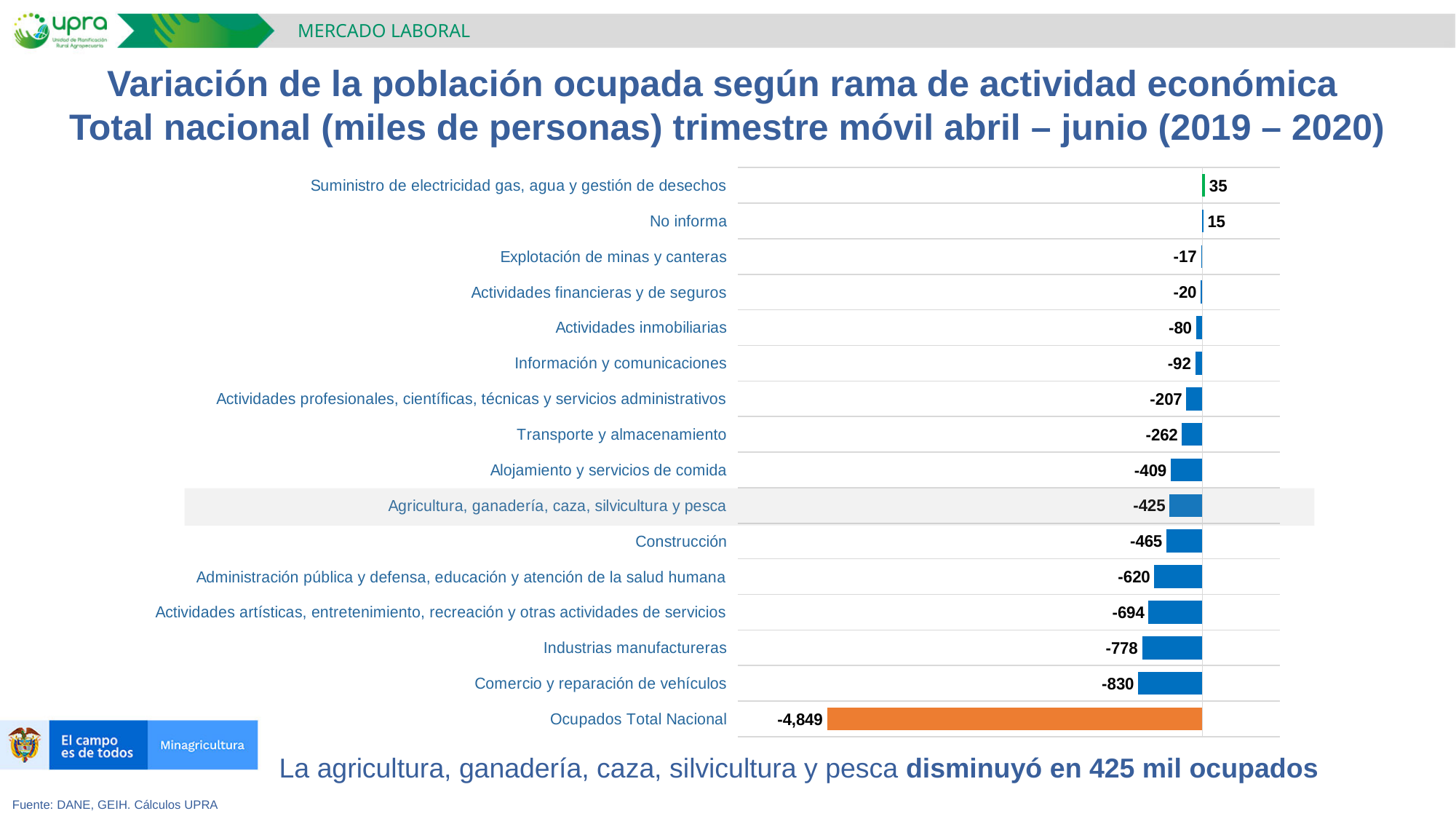
How many categories are shown in the chart? 16 Which shows a larger decrease, Construcción or Alojamiento y servicios de comida? Construcción What is the difference between the values for Industrias manufactureras and Comercio y reparación de vehículos? 52 What is the value for Ocupados Total Nacional? -4,849 What is the value for Comercio y reparación de vehículos? -830 What colour is the bar for Ocupados Total Nacional? Orange Which has the larger value, Suministro de electricidad gas, agua y gestión de desechos or No informa? Suministro de electricidad gas, agua y gestión de desechos Which category has the highest value? Suministro de electricidad gas, agua y gestión de desechos What kind of chart is shown on the slide? Bar chart Which category has the lowest value? Ocupados Total Nacional What is the value for Industrias manufactureras? -778 What is the value for Agricultura, ganadería, caza, silvicultura y pesca? -425